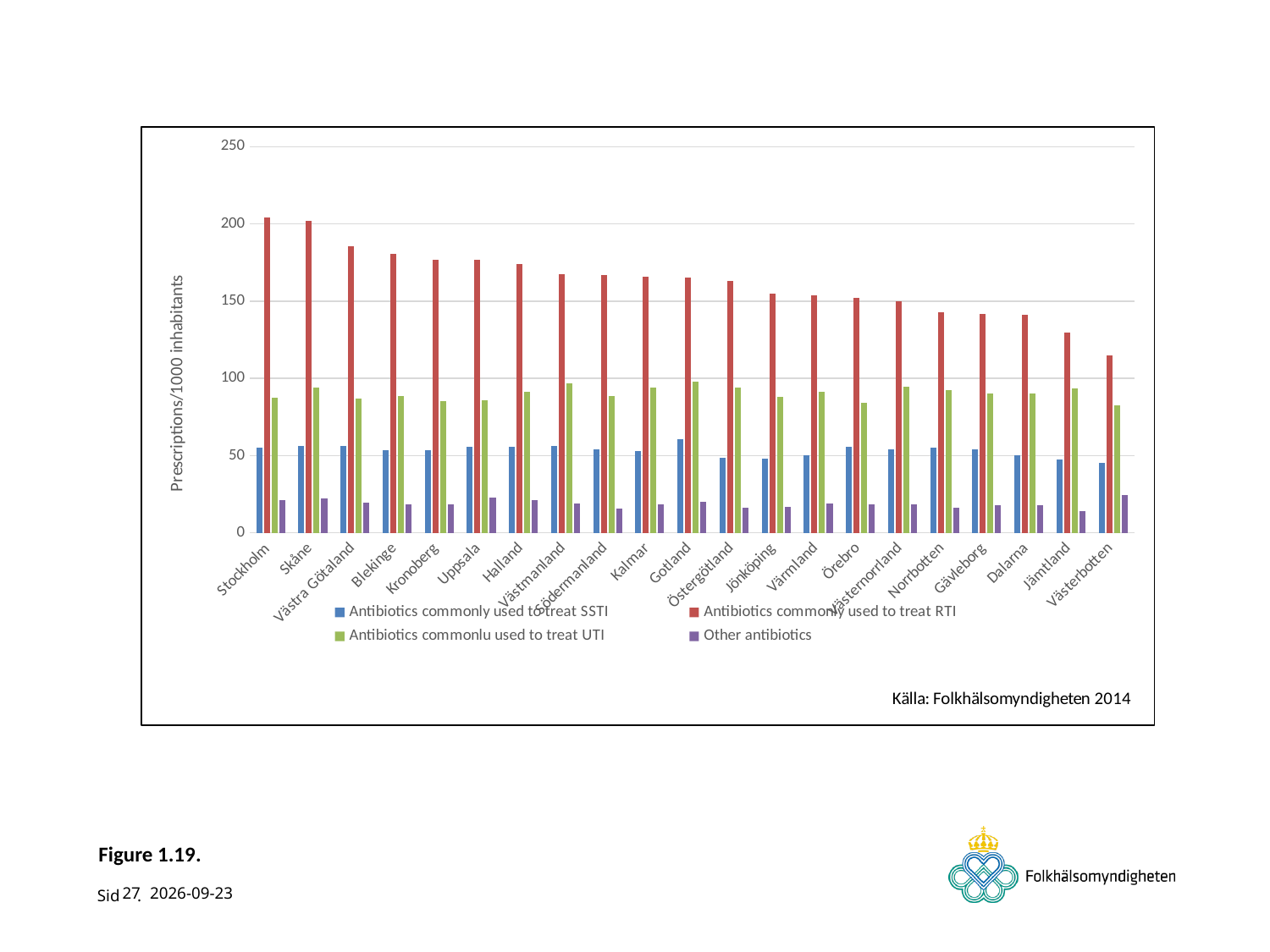
Is the value for antibiotics commonly used to treat RTI in Västerbotten greater or less than 100? greater Which is larger: the RTI antibiotics value for Stockholm or for Västerbotten? Stockholm Is the value for Other antibiotics in Västerbotten greater or less than 50? less Is the value for antibiotics commonly used to treat RTI in Jämtland greater or less than 150? less What is the label of the y axis? Prescriptions/1000 inhabitants Which region has the lowest value for antibiotics commonly used to treat RTI? Västerbotten How many regions (categories) are shown on the x axis? 21 In Gotland, which is larger: the value for antibiotics commonly used to treat SSTI or for Other antibiotics? Antibiotics commonly used to treat SSTI What kind of chart is shown on the slide? bar chart How many series does the legend list? 4 Do the values for antibiotics commonly used to treat RTI rise or fall from left to right along the x axis? fall